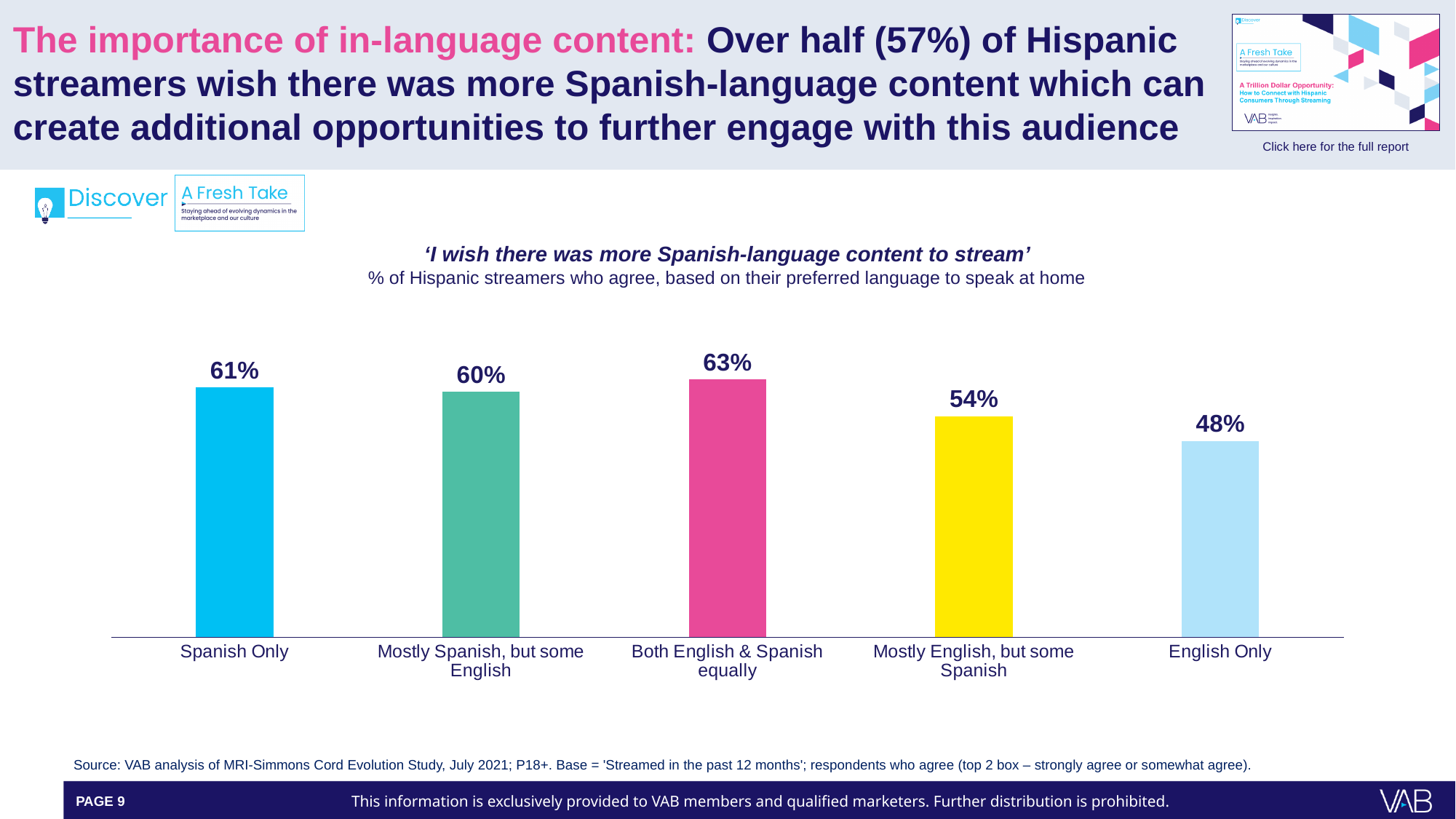
What is the difference between the values for 'Spanish Only' and 'Mostly English, but some Spanish'? 7% Which is larger: the value for 'Mostly Spanish, but some English' or the value for 'Mostly English, but some Spanish'? Mostly Spanish, but some English What statement is the chart measuring agreement with? 'I wish there was more Spanish-language content to stream' Which category has the highest percentage of agreement? Both English & Spanish equally What colour is the bar for 'Both English & Spanish equally'? Pink Which category has the lowest percentage of agreement? English Only What is the difference between the values for 'Both English & Spanish equally' and 'English Only'? 15% What is the value for 'Mostly English, but some Spanish'? 54% What percentage of Spanish Only Hispanic streamers agree they wish there was more Spanish-language content to stream? 61% How many categories are shown in the chart? 5 What is the value for the 'English Only' category? 48% What kind of chart is shown on the slide? Bar chart